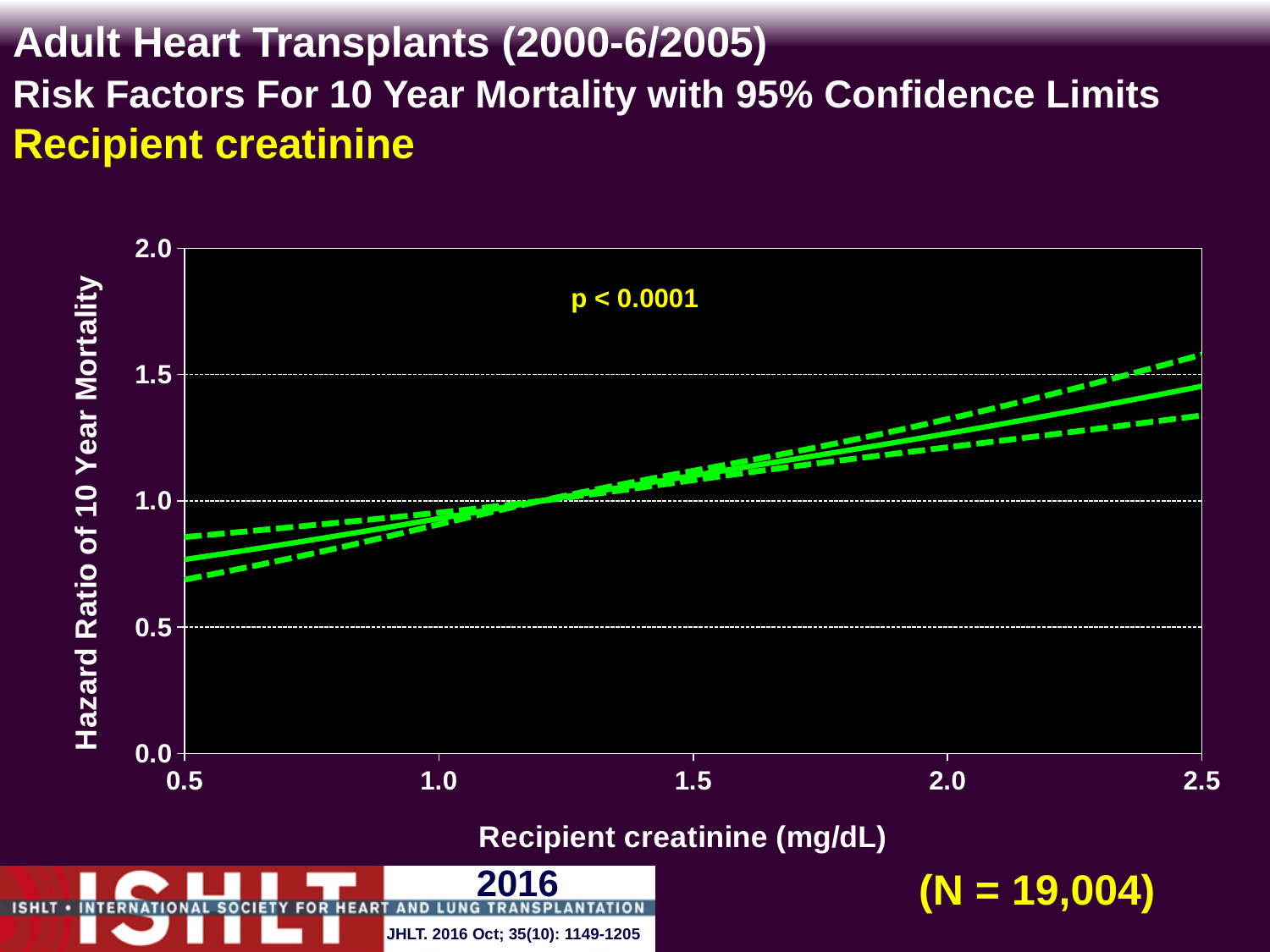
Is the hazard ratio at a recipient creatinine of 0.5 mg/dL greater or less than 0.5? greater What kind of chart is shown on the slide? line chart Is the hazard ratio higher at a recipient creatinine of 2.0 mg/dL or at 1.0 mg/dL? 2.0 mg/dL What is the highest value shown on the y axis? 2.0 What is the sample size (N) shown on the slide? 19,004 What is the p-value shown on the chart? p < 0.0001 Is the hazard ratio at a recipient creatinine of 2.5 mg/dL greater or less than 2.0? less Does the hazard ratio of 10 year mortality rise or fall as recipient creatinine increases from 0.5 to 2.5 mg/dL? rise How many lines are plotted on the chart? 3 Is the hazard ratio at a recipient creatinine of 0.5 mg/dL greater or less than 1.0? less What is the label of the x axis? Recipient creatinine (mg/dL)